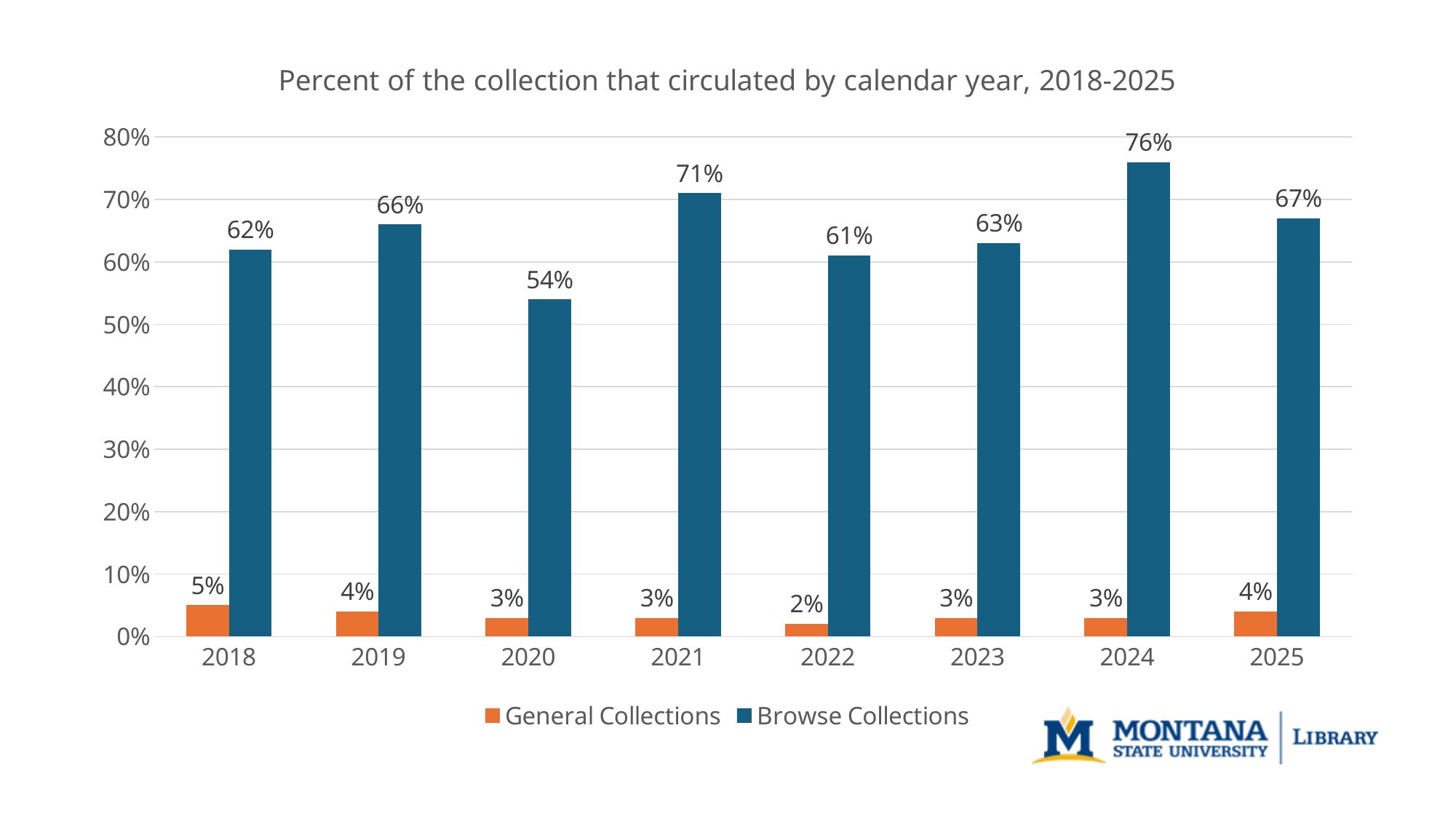
What percent of the Browse Collections circulated in 2021? 71% What kind of chart is shown on the slide? bar chart What percent of the Browse Collections circulated in 2020? 54% How many years are shown on the x axis? 8 In which year was the Browse Collections circulation percentage lowest? 2020 How many series does the legend list? 2 What percent of the General Collections circulated in 2018? 5% In which year was the Browse Collections circulation percentage highest? 2024 What is the difference between the Browse Collections percentages for 2024 and 2020? 22% Is the Browse Collections value for 2022 greater or less than 70%? less In which year was the General Collections circulation percentage lowest? 2022 Which is larger, the Browse Collections percentage in 2019 or in 2025? 2025